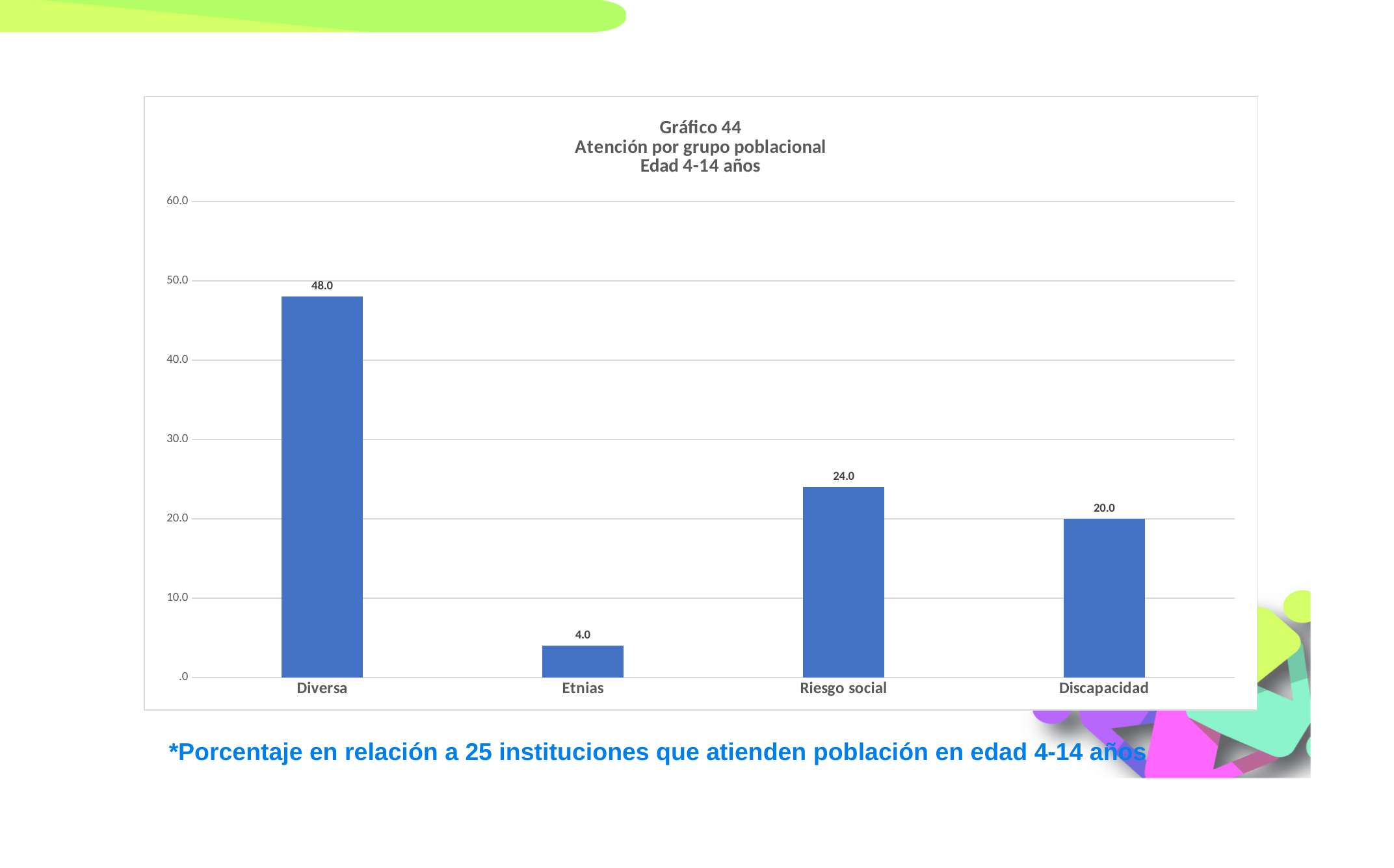
What is the difference between the values for Diversa and Riesgo social? 24.0 What is the value for Diversa? 48.0 Which category has the lowest value? Etnias Which category has the highest value? Diversa What is the value for Riesgo social? 24.0 Is the value for Diversa greater or less than 40.0? greater What is the difference between the values for Riesgo social and Discapacidad? 4.0 What kind of chart is shown on the slide? Bar chart How many categories are shown on the x axis? 4 Which is larger, the value for Riesgo social or the value for Discapacidad? Riesgo social What is the value for Discapacidad? 20.0 What is the value for Etnias? 4.0